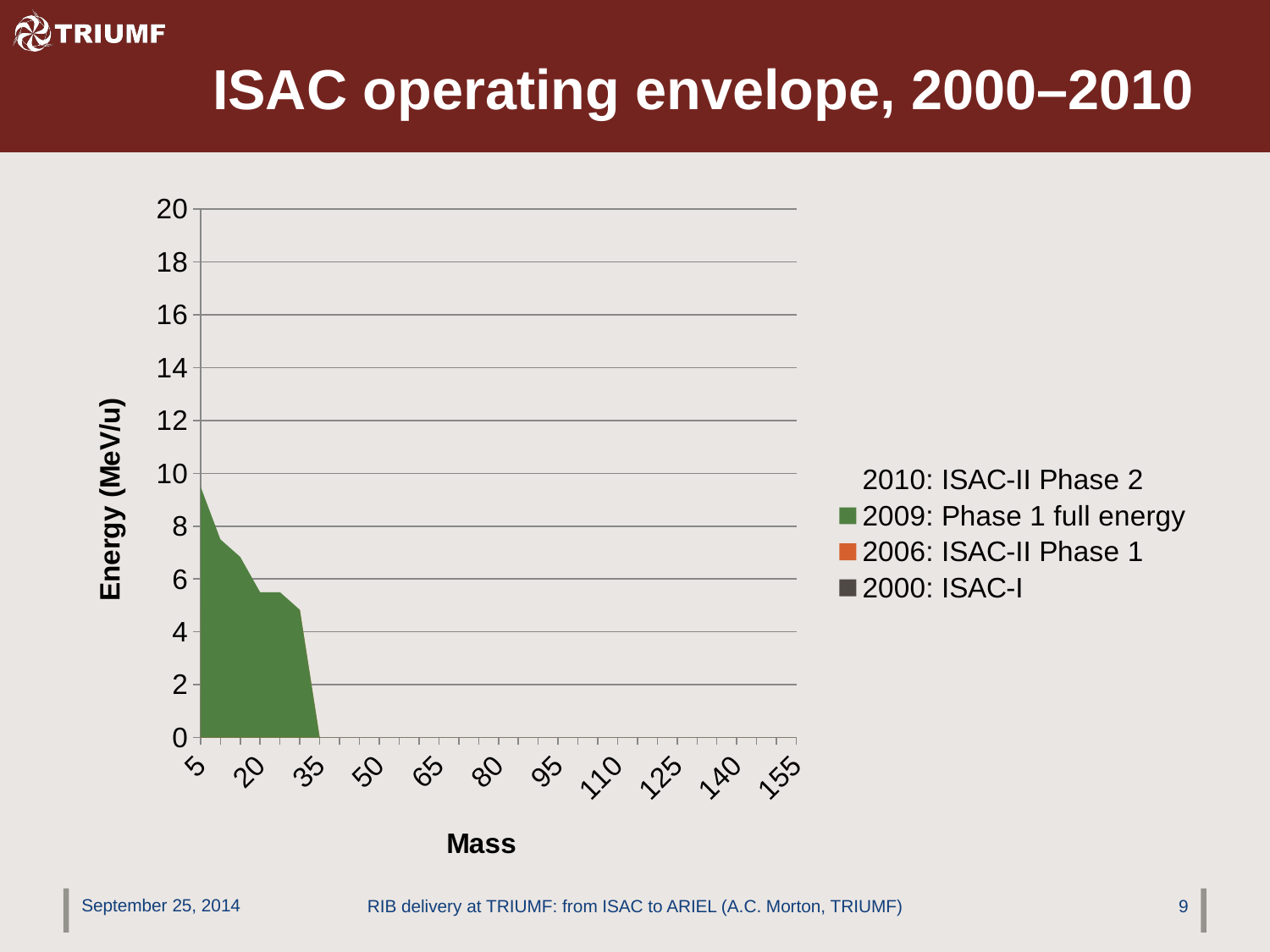
Does the energy for the 2009: Phase 1 full energy series rise or fall as mass increases? fall Is the energy value for the 2009: Phase 1 full energy series at mass 20 greater or less than 8? less What kind of chart is shown on the slide? Area chart How many mass values are labelled on the horizontal axis? 11 Which is larger for the 2009: Phase 1 full energy series, the energy at mass 5 or at mass 20? mass 5 What is the label of the vertical axis? Energy (MeV/u) What is the highest value shown on the vertical axis? 20 How many series does the legend list? 4 Is the energy value for the 2009: Phase 1 full energy series at mass 5 greater or less than 8? greater Is the energy value for the 2009: Phase 1 full energy series at mass 5 greater or less than 10? less What is the title of the chart on the slide? ISAC operating envelope, 2000–2010